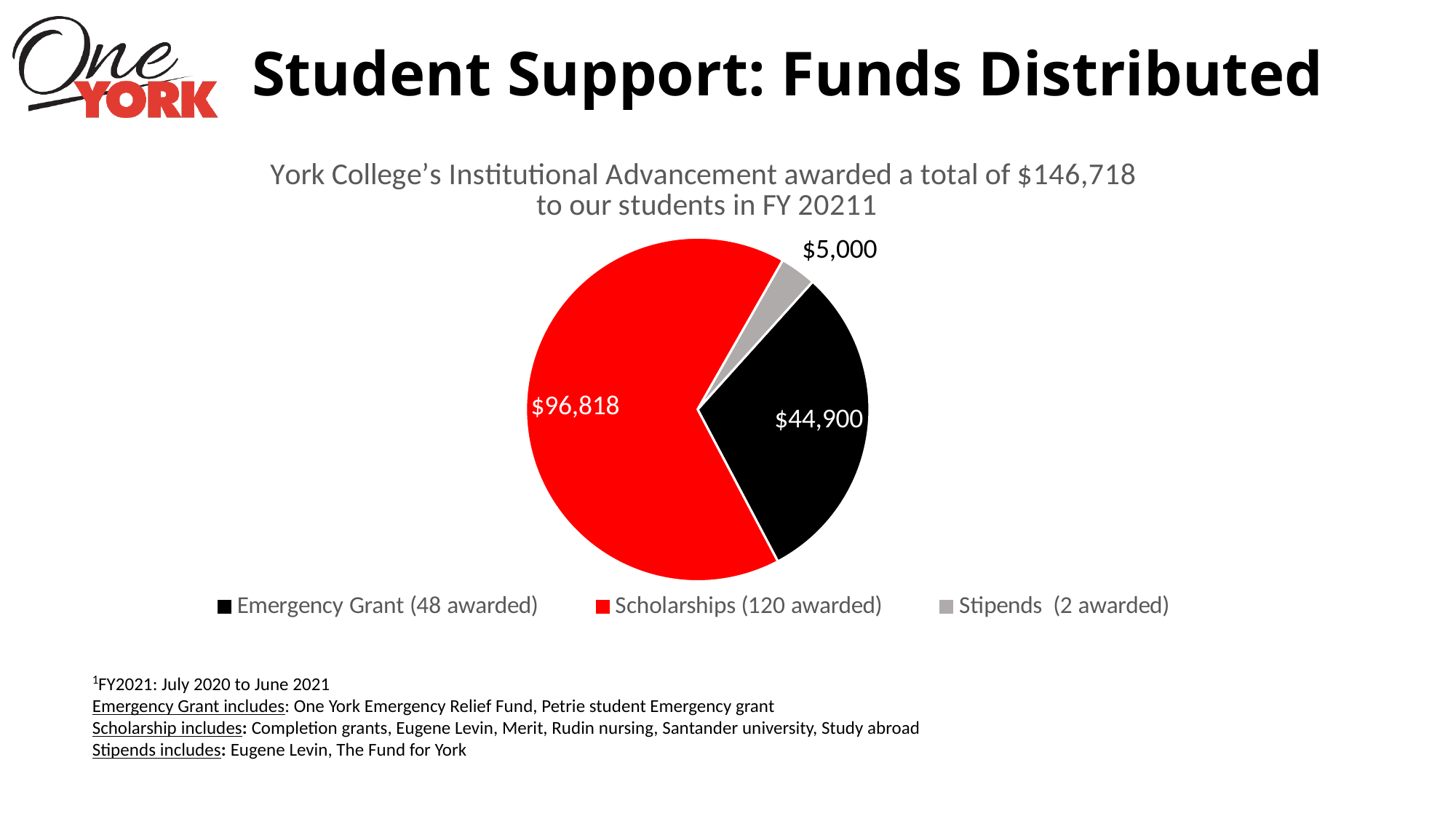
How many categories does the pie chart show? 3 What kind of chart is shown on the slide? Pie chart Which is larger: the Emergency Grant amount or the Stipends amount? Emergency Grant Which category received the largest amount of funds? Scholarships How much more was distributed in Emergency Grants than in Stipends? $39,900 What amount was distributed as Scholarships? $96,818 What amount was distributed as Stipends? $5,000 What amount was distributed as Emergency Grants? $44,900 Which category received the smallest amount of funds? Stipends How much more was distributed in Scholarships than in Emergency Grants? $51,918 What is the total amount of funds shown in the pie chart? $146,718 Which colour represents Scholarships in the pie chart? Red